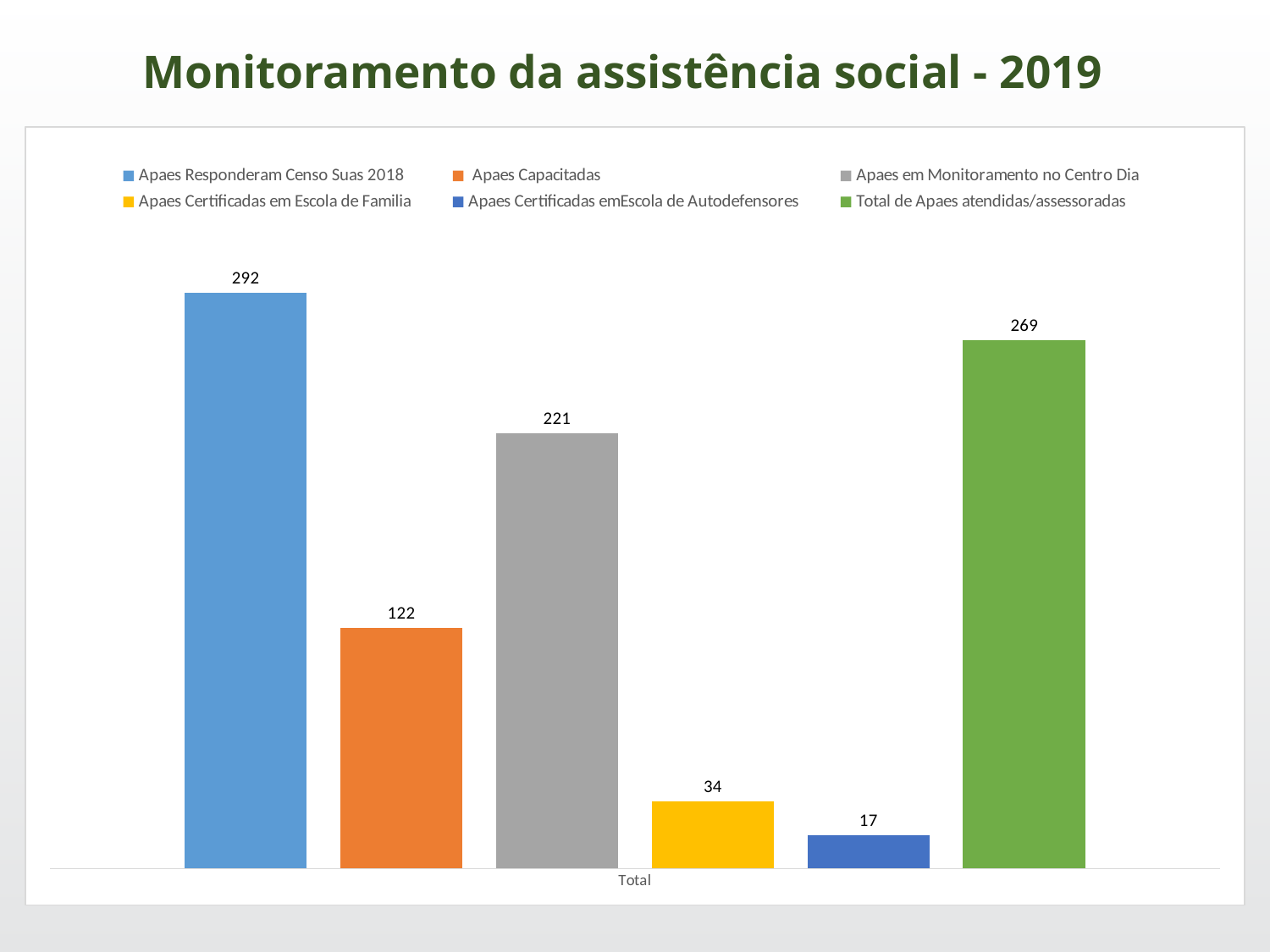
Which is larger: Apaes Capacitadas or Apaes em Monitoramento no Centro Dia? Apaes em Monitoramento no Centro Dia What colour is the bar for Total de Apaes atendidas/assessoradas? Green Which series has the highest value? Apaes Responderam Censo Suas 2018 How many series does the legend list? 6 What is the value for Apaes Certificadas em Escola de Familia? 34 What kind of chart is shown? Bar chart What is the value for Total de Apaes atendidas/assessoradas? 269 What is the difference between Apaes Responderam Censo Suas 2018 and Total de Apaes atendidas/assessoradas? 23 What is the value for Apaes em Monitoramento no Centro Dia? 221 Which series has the lowest value? Apaes Certificadas emEscola de Autodefensores What is the value for Apaes Capacitadas? 122 What is the value for Apaes Responderam Censo Suas 2018? 292